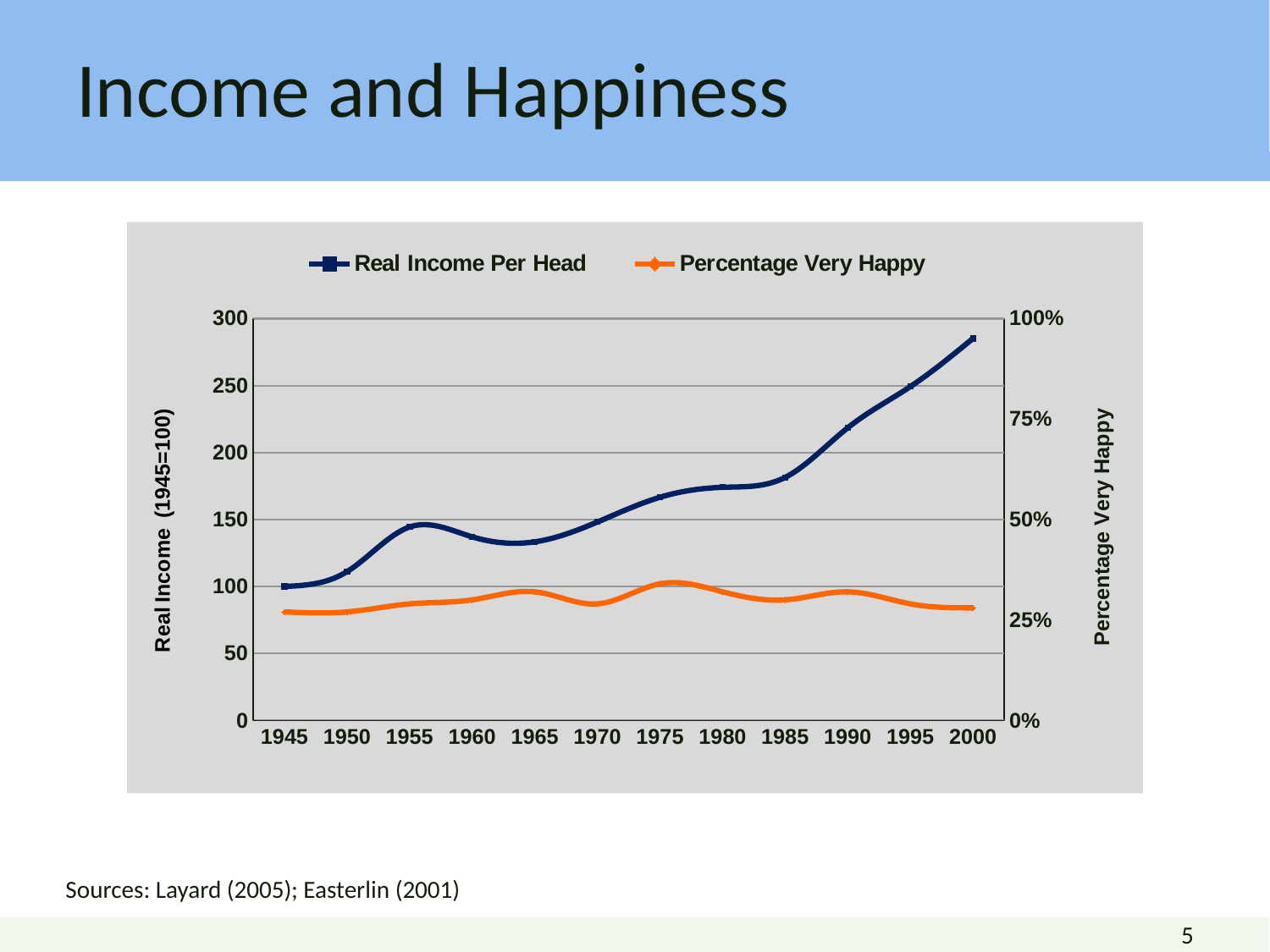
Is the value for Real Income Per Head in 2000 greater or less than 250? greater What is the value of Real Income Per Head in 1945? 100 How many series does the legend list? 2 In which year is Real Income Per Head highest? 2000 Which is larger, Real Income Per Head in 1990 or in 1960? 1990 Does Real Income Per Head rise or fall overall from 1945 to 2000? rise Is the value for Percentage Very Happy in 2000 greater or less than 50%? less Is the value for Real Income Per Head in 1990 greater or less than 200? greater What is the title of the right-hand vertical axis? Percentage Very Happy What kind of chart is shown on the slide? line chart In which year is Real Income Per Head lowest? 1945 How many years are marked along the x axis? 12